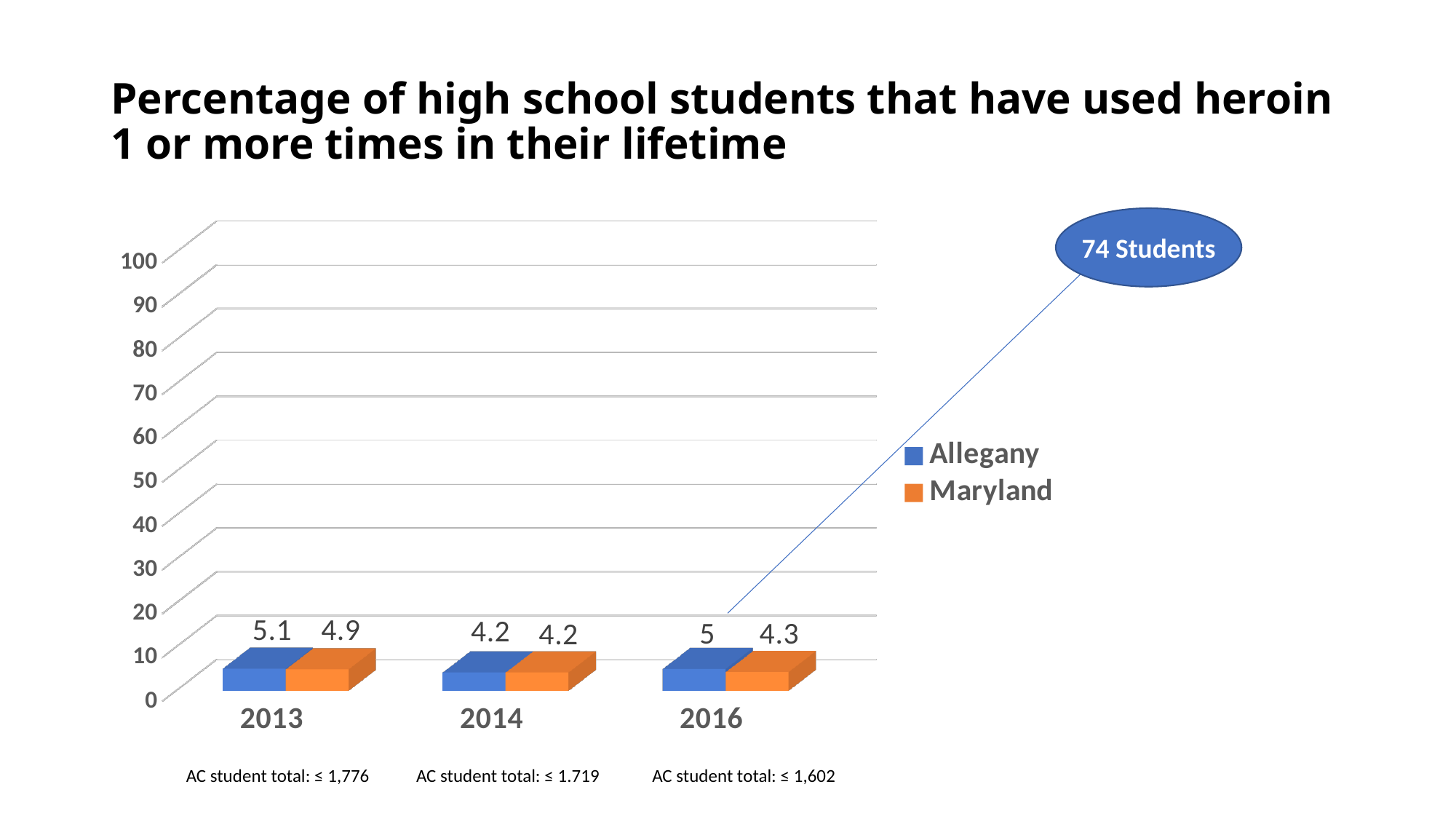
How many series does the legend list? 2 How many years are shown on the x axis? 3 What kind of chart is shown on the slide? bar chart What is the Maryland value for 2016? 4.3 What is the Maryland value for 2014? 4.2 What is the difference between the Allegany and Maryland values in 2016? 0.7 What is the Allegany value for 2016? 5 In which year is the Allegany value highest? 2013 Is the Allegany value for 2013 greater or less than 10? less Which is larger in 2013, the Allegany value or the Maryland value? Allegany What is the Allegany value for 2013? 5.1 In which year is the Allegany value lowest? 2014